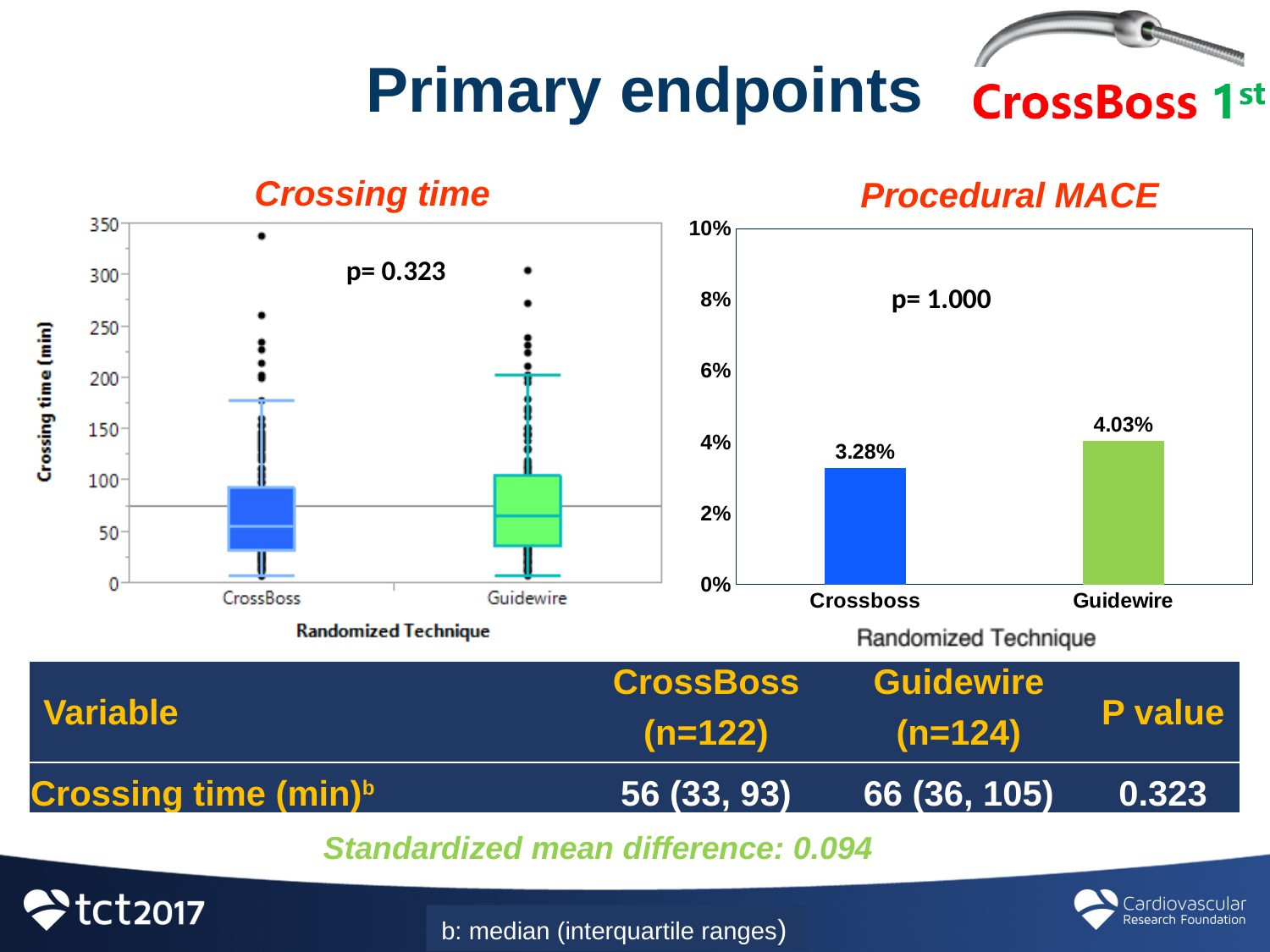
In the Procedural MACE chart, what is the value for Crossboss? 3.28% What kind of chart is the Procedural MACE chart? Bar chart In the Procedural MACE chart, which technique has the higher MACE rate? Guidewire In the Procedural MACE chart, how many categories are shown on the x axis? 2 In the Procedural MACE chart, is the value for Crossboss greater or less than 4%? less In the Crossing time chart, is the median crossing time for Guidewire greater or less than 100? less In the Procedural MACE chart, what is the difference between the Guidewire and Crossboss values? 0.75% What p value is printed on the Crossing time chart? p= 0.323 In the Crossing time chart, is the highest outlier for CrossBoss greater or less than 300? greater What p value is printed on the Procedural MACE chart? p= 1.000 In the Procedural MACE chart, which technique has the lower MACE rate? Crossboss In the Procedural MACE chart, what is the value for Guidewire? 4.03%